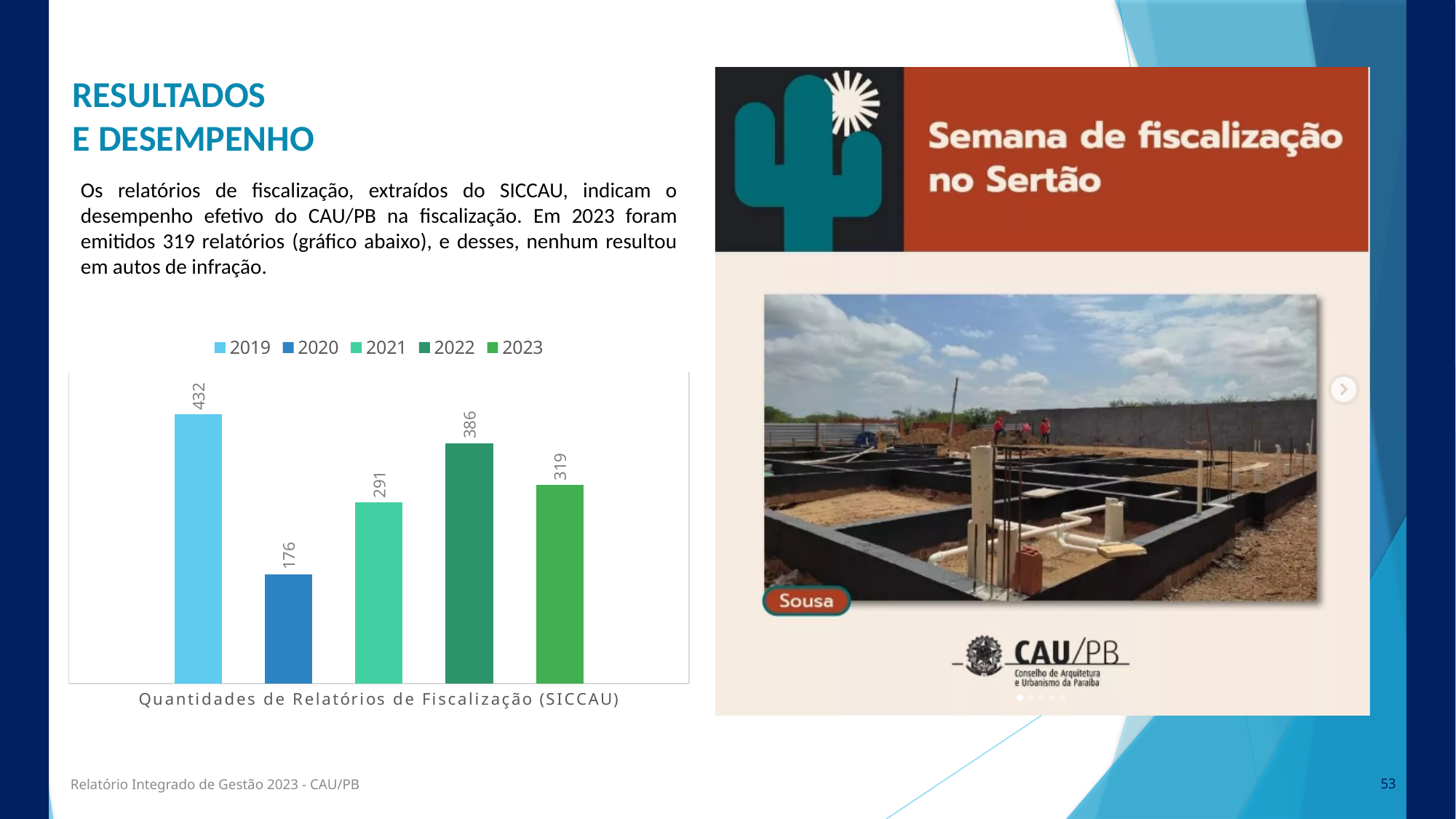
What is the value for 2021 in the chart? 291 Which year has the lowest value in the chart? 2020 What is the difference between the values for 2022 and 2023? 67 What is the value for 2020 in the chart? 176 What is the difference between the values for 2019 and 2020? 256 What is the value for 2023 in the chart? 319 What is the value for 2022 in the chart? 386 Which is larger, the value for 2021 or the value for 2023? 2023 How many years are shown in the chart? 5 What kind of chart is shown on the slide? Bar chart What is the value for 2019 in the chart? 432 Which year has the highest value in the chart? 2019